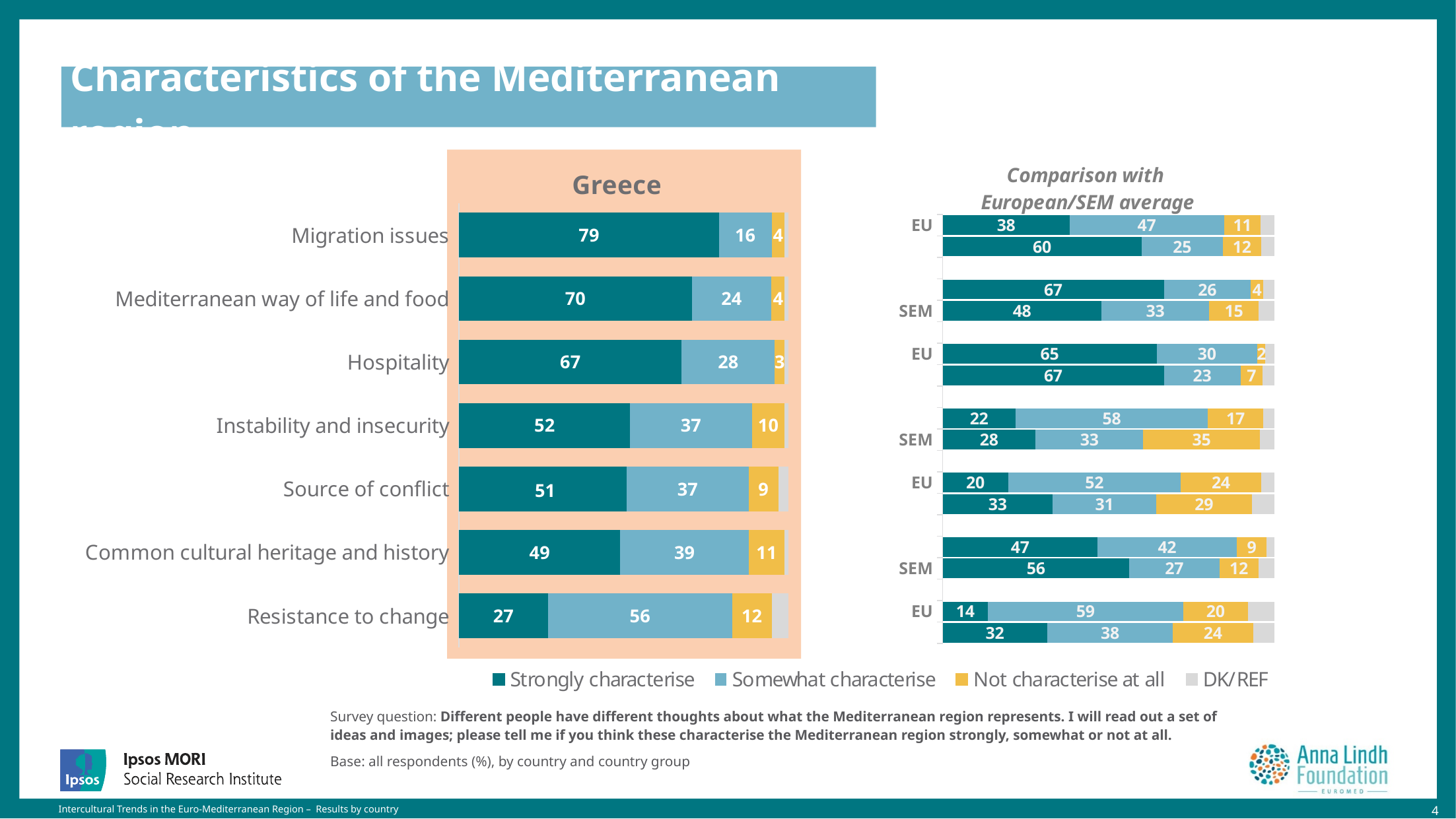
In the Greece chart, what is the difference between the 'Strongly characterise' values for Hospitality and Instability and insecurity? 15 In the Greece chart, what is the 'Somewhat characterise' value for Resistance to change? 56 In the Greece chart, which is larger: the 'Strongly characterise' value for Mediterranean way of life and food or for Source of conflict? Mediterranean way of life and food How many categories are shown in the Greece chart? 7 In the Greece chart, which category has the highest 'Strongly characterise' value? Migration issues How many series does the legend list? 4 In the Greece chart, what is the 'Not characterise at all' value for Common cultural heritage and history? 11 What type of chart is the Greece chart? Stacked bar chart In the Comparison with European/SEM average chart, what is the 'Strongly characterise' value for the top EU bar? 38 In the Comparison with European/SEM average chart, what is the 'Not characterise at all' value for the bottom SEM bar? 24 In the Greece chart, what percentage say migration issues strongly characterise the Mediterranean region? 79 In the Greece chart, which category has the lowest 'Strongly characterise' value? Resistance to change